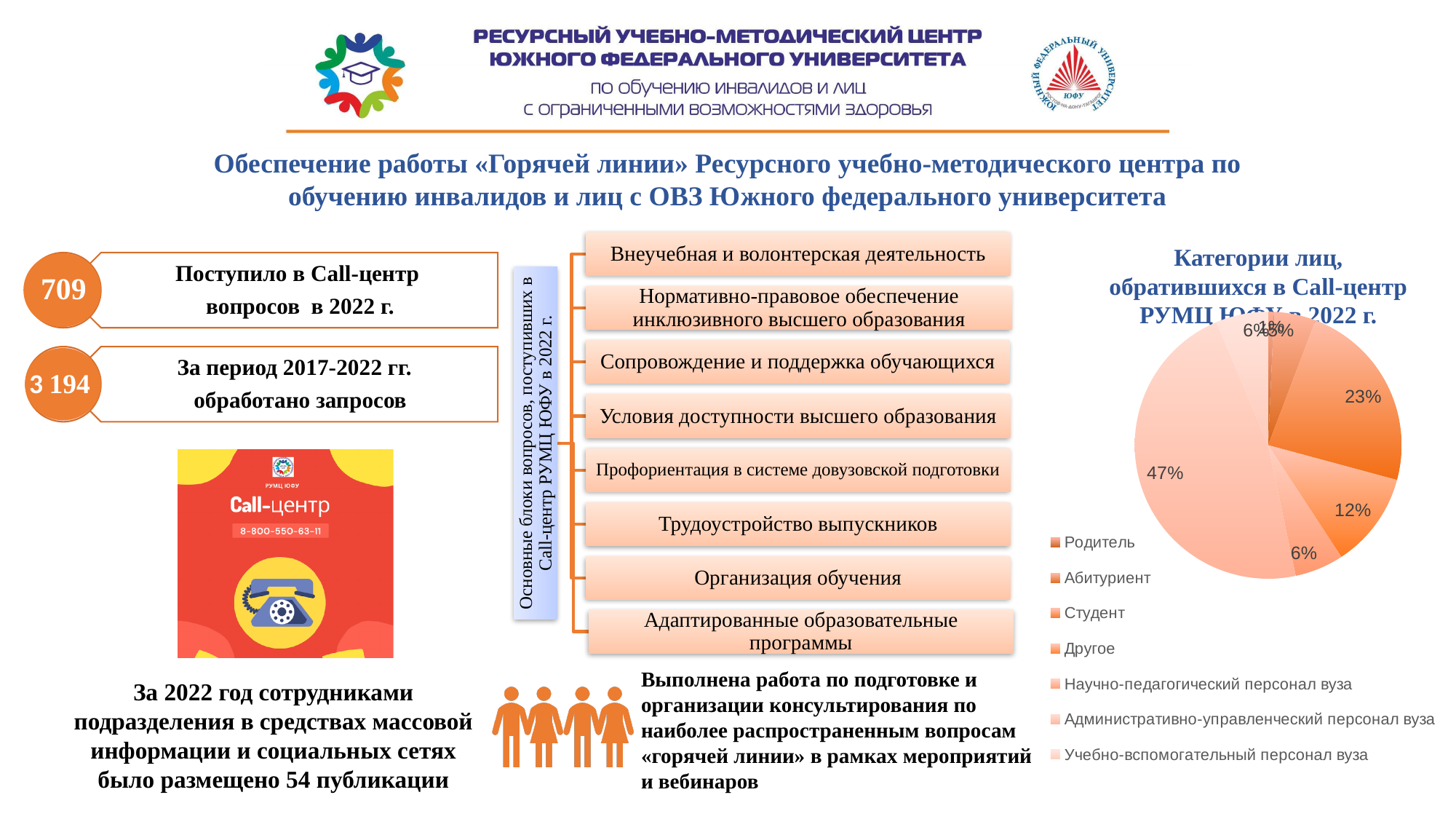
What share of the pie chart corresponds to Абитуриент? 5% How many categories does the legend of the pie chart list? 7 What is the largest share shown in the pie chart? 47% Which is larger in the pie chart: Научно-педагогический персонал вуза or Абитуриент? Научно-педагогический персонал вуза Is the share for Студент in the pie chart greater or less than 20%? greater Which is larger in the pie chart: the share for Абитуриент or the share for Студент? Студент What kind of chart is shown on the right side of the slide? pie chart What share of the pie chart corresponds to Другое? 12% What share of the pie chart corresponds to Студент? 23% What is the title of the pie chart? Категории лиц, обратившихся в Call-центр РУМЦ ЮФУ в 2022 г. Which category has the largest slice in the pie chart? Административно-управленческий персонал вуза